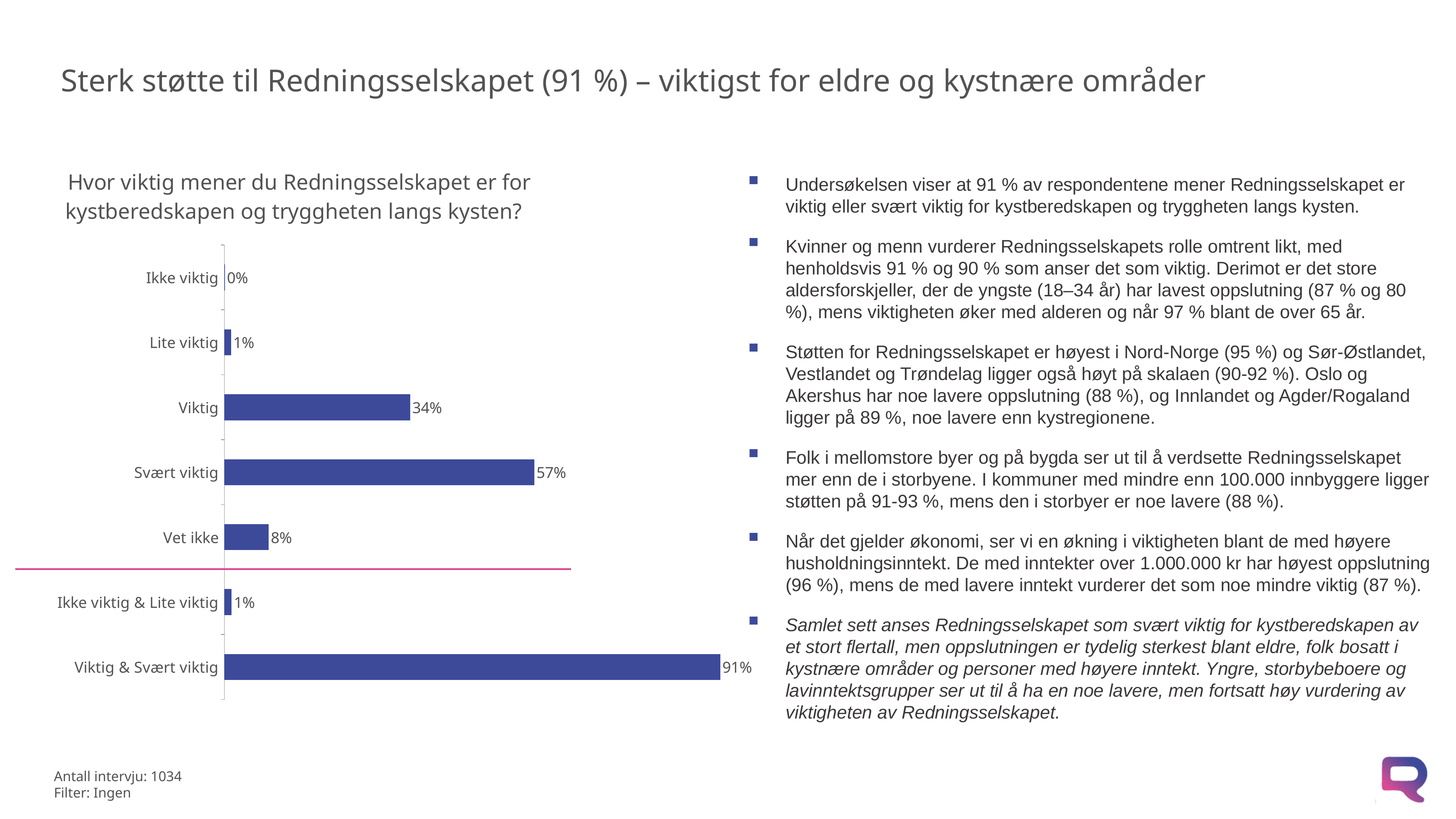
What is the difference between "Svært viktig" and "Viktig"? 23% What is the value for "Viktig & Svært viktig"? 91% What kind of chart is shown on the slide? Bar chart Which category has the highest value? Viktig & Svært viktig Which category has the lowest value? Ikke viktig How many categories are shown in the chart? 7 What is the value for "Vet ikke"? 8% What is the value for "Viktig"? 34% Which is larger, "Vet ikke" or "Lite viktig"? Vet ikke What is the title of the chart? Hvor viktig mener du Redningsselskapet er for kystberedskapen og tryggheten langs kysten? What is the value for "Ikke viktig"? 0% What is the value for "Svært viktig"? 57%